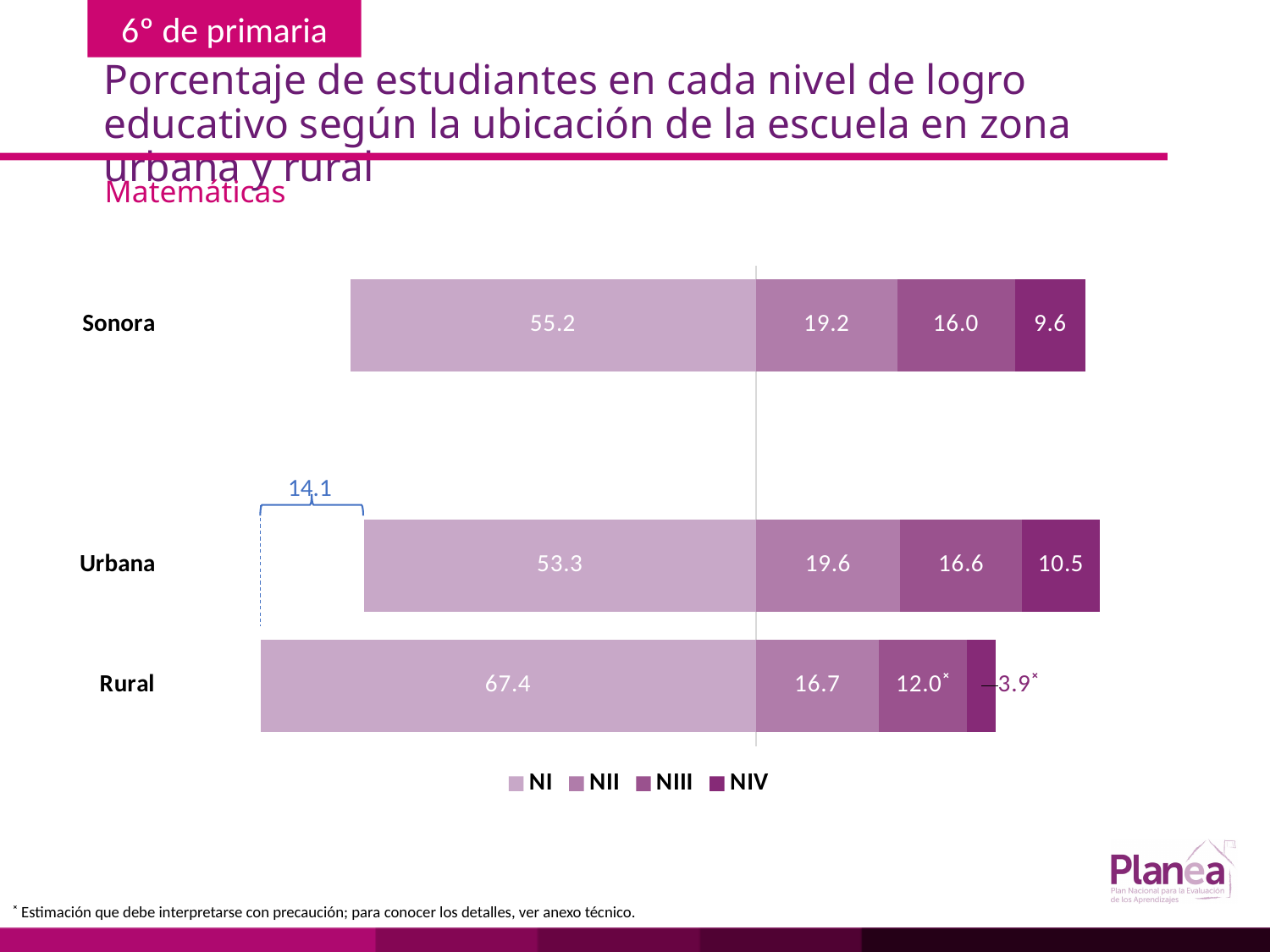
How many series does the legend list? 4 Which is larger, the NIII value for Urbana or the NIII value for Sonora? Urbana What is the NII value for Sonora? 19.2 What is the difference between the NI values for Rural and Urbana? 14.1 Which category has the highest NI value? Rural What is the total of the stacked bar for Sonora? 100.0 What is the NIII value for Rural? 12.0 What kind of chart is shown on the slide? Stacked bar chart Which category has the lowest NIV value? Rural How many categories are shown on the chart? 3 What is the NIV value for Urbana? 10.5 What percentage of Rural students are at level NI? 67.4